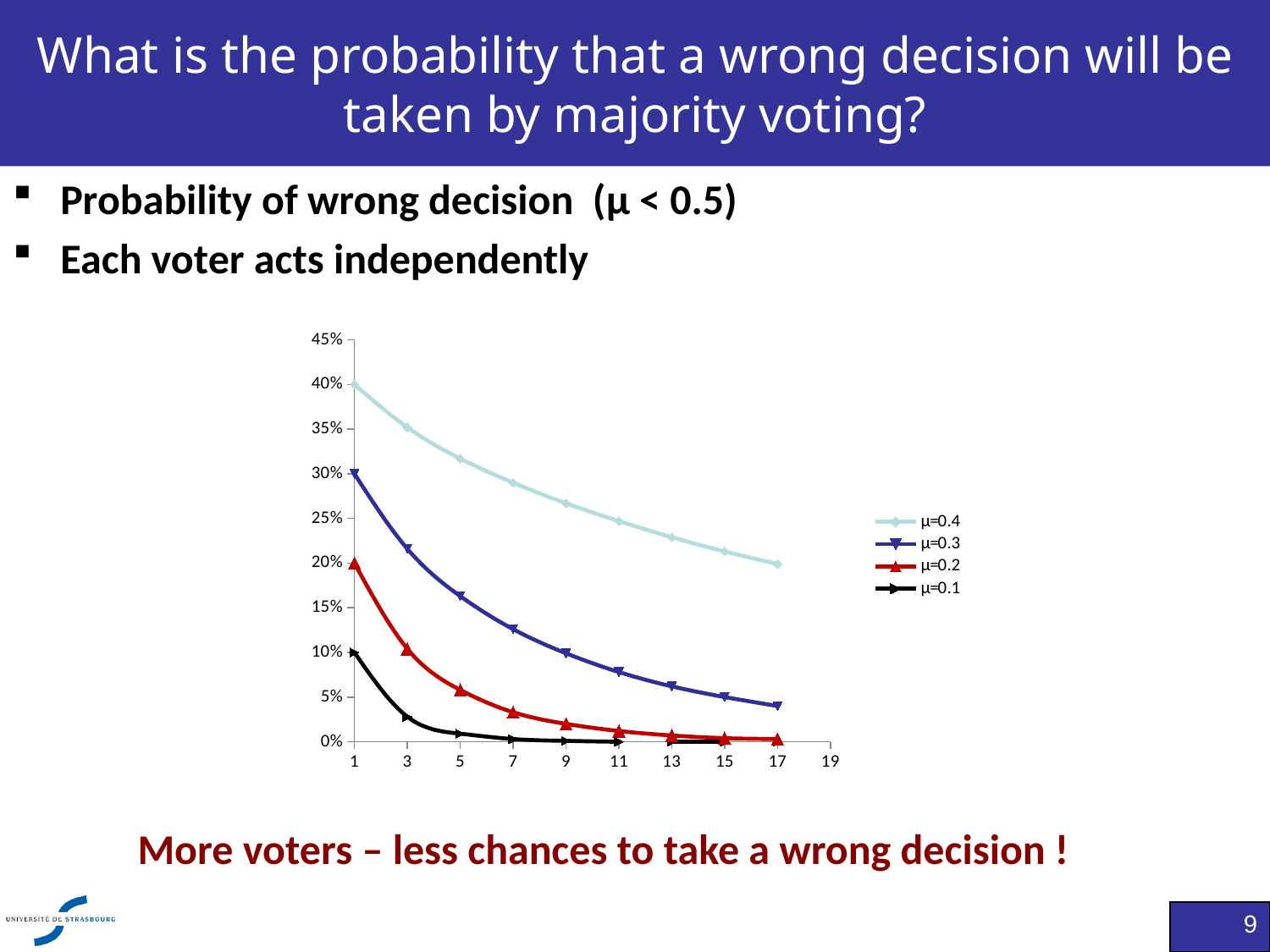
What kind of chart is shown on the slide? line chart What is the value of the μ=0.4 series at x = 1? 40% What is the value of the μ=0.3 series at x = 1? 30% What is the value of the μ=0.2 series at x = 1? 20% Which series has the highest value at x = 1? μ=0.4 At x = 9, which series has the larger value, μ=0.4 or μ=0.3? μ=0.4 Is the value of the μ=0.4 series at x = 9 greater or less than 25%? greater How many series does the legend list? 4 What is the value of the μ=0.1 series at x = 1? 10% Do the values of the μ=0.3 series rise or fall as x increases? fall What is the difference between the μ=0.4 and μ=0.1 series at x = 1? 30% Which series has the lowest value at x = 1? μ=0.1